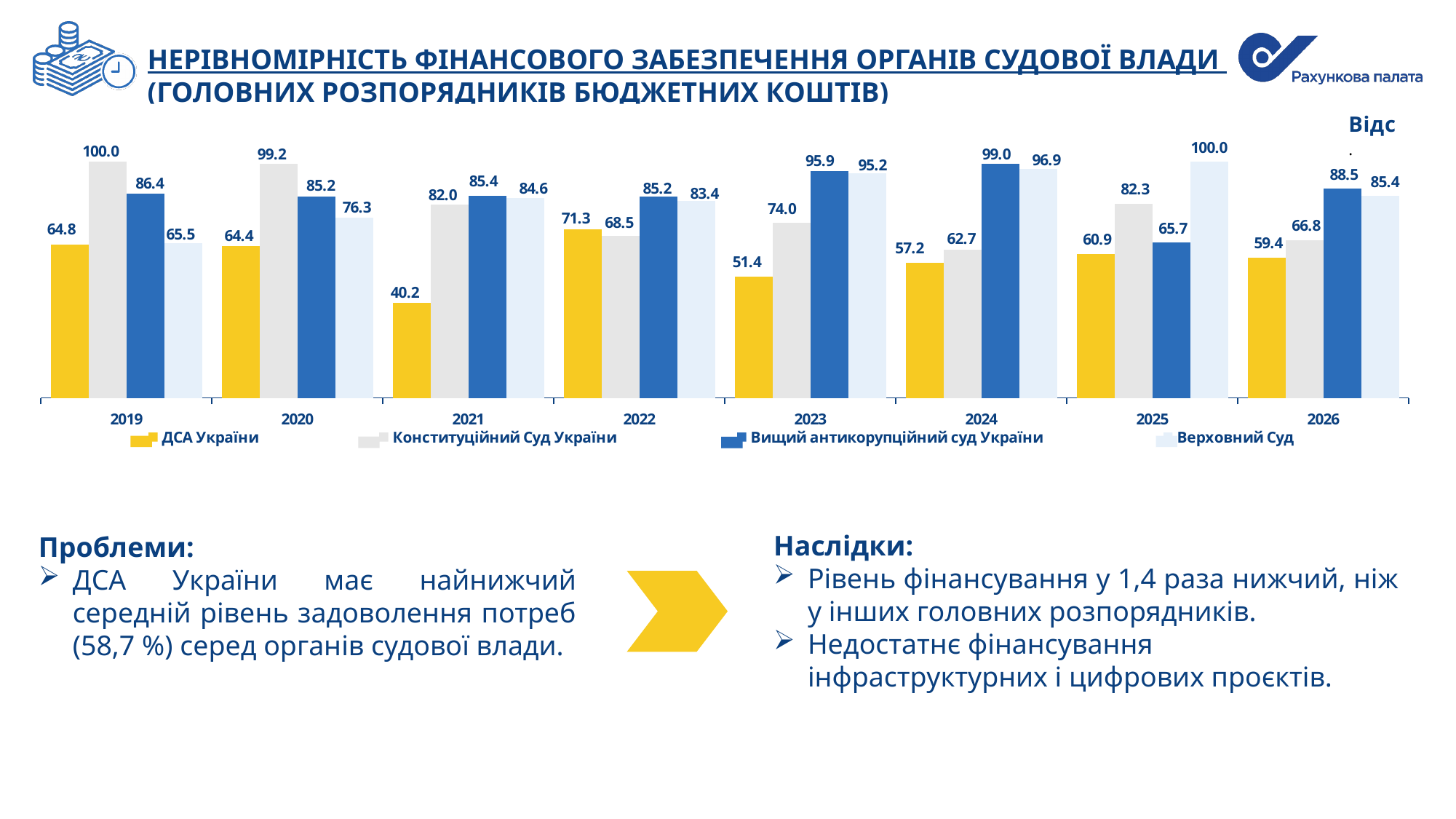
What kind of chart is shown on the slide? Bar chart What is the value for Конституційний Суд України in 2026? 66.8 What is the difference between the Конституційний Суд України value and the ДСА України value in 2019? 35.2 How many series does the legend list? 4 How many years are shown on the x axis of the chart? 8 In which year is the value for Конституційний Суд України the highest? 2019 What is the value for ДСА України in 2021? 40.2 Which is larger in 2022: the value for ДСА України or the value for Конституційний Суд України? ДСА України Which series is shown in yellow in the chart? ДСА України In which year is the value for ДСА України the lowest? 2021 What is the value for Вищий антикорупційний суд України in 2024? 99.0 What is the value for Верховний Суд in 2025? 100.0